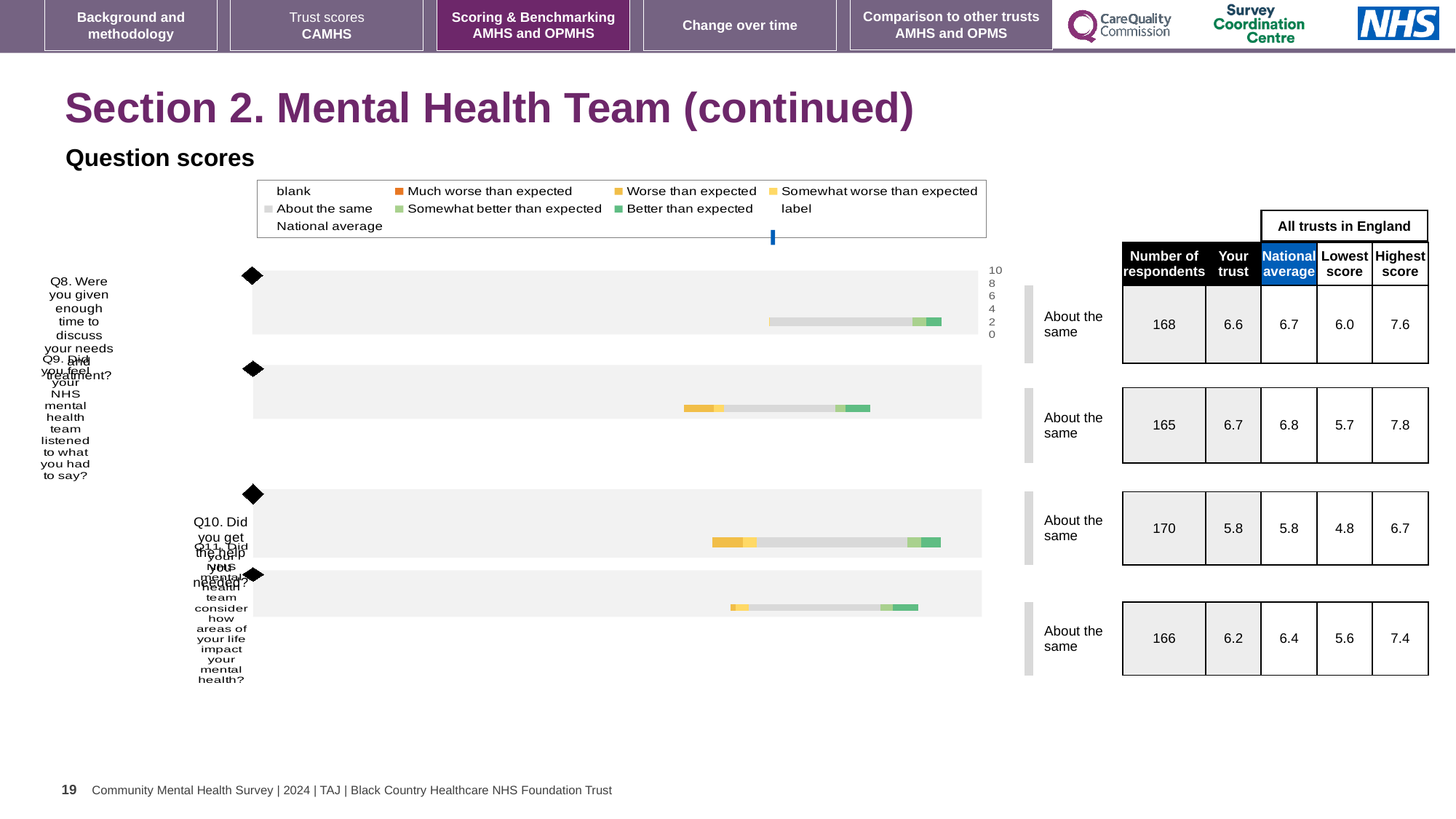
For Q8, which is larger in the table beside the chart: the 'Your trust' score or the national average? National average What kind of chart is used to show the question scores on this slide? bar chart What is the heading above the chart on this slide? Question scores Which question has the lowest 'Your trust' score in the table beside the chart? Q10 According to the table beside the chart, what is the 'Your trust' score for Q8? 6.6 How many entries does the legend of the question scores chart list? 9 How many questions (categories) are plotted in the question scores chart? 4 According to the table beside the chart, what is the national average for Q10? 5.8 According to the table beside the chart, what is the lowest score for Q11? 5.6 Which question has the highest number of respondents in the table beside the chart? Q10 What is the difference between the highest score and the lowest score for Q9 in the table beside the chart? 2.1 What colour represents 'Much worse than expected' in the chart legend? orange